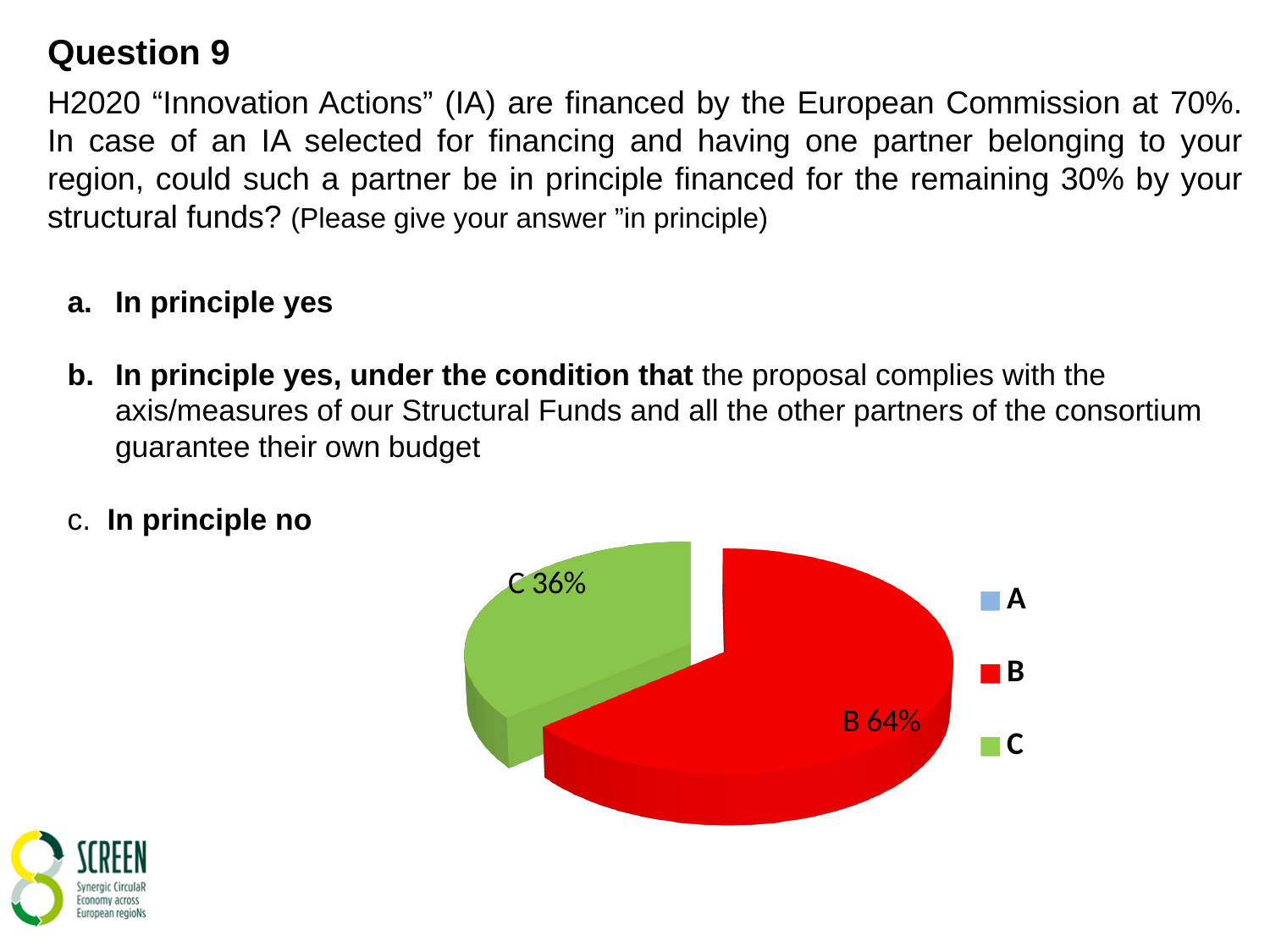
Which of the visible slices is the smallest in the pie chart? C What colour is slice C in the pie chart? green What share of the pie does slice C represent? 36% Which is larger, slice B or slice C? B What colour is slice B in the pie chart? red Which slice is the largest in the pie chart? B How many entries does the legend list? 3 How many slices with data labels are visible in the pie chart? 2 What is the difference in percentage points between slice B and slice C? 28 What share of the pie does slice B represent? 64% Is the share for slice B greater or less than 50%? greater What kind of chart is shown on the slide? pie chart